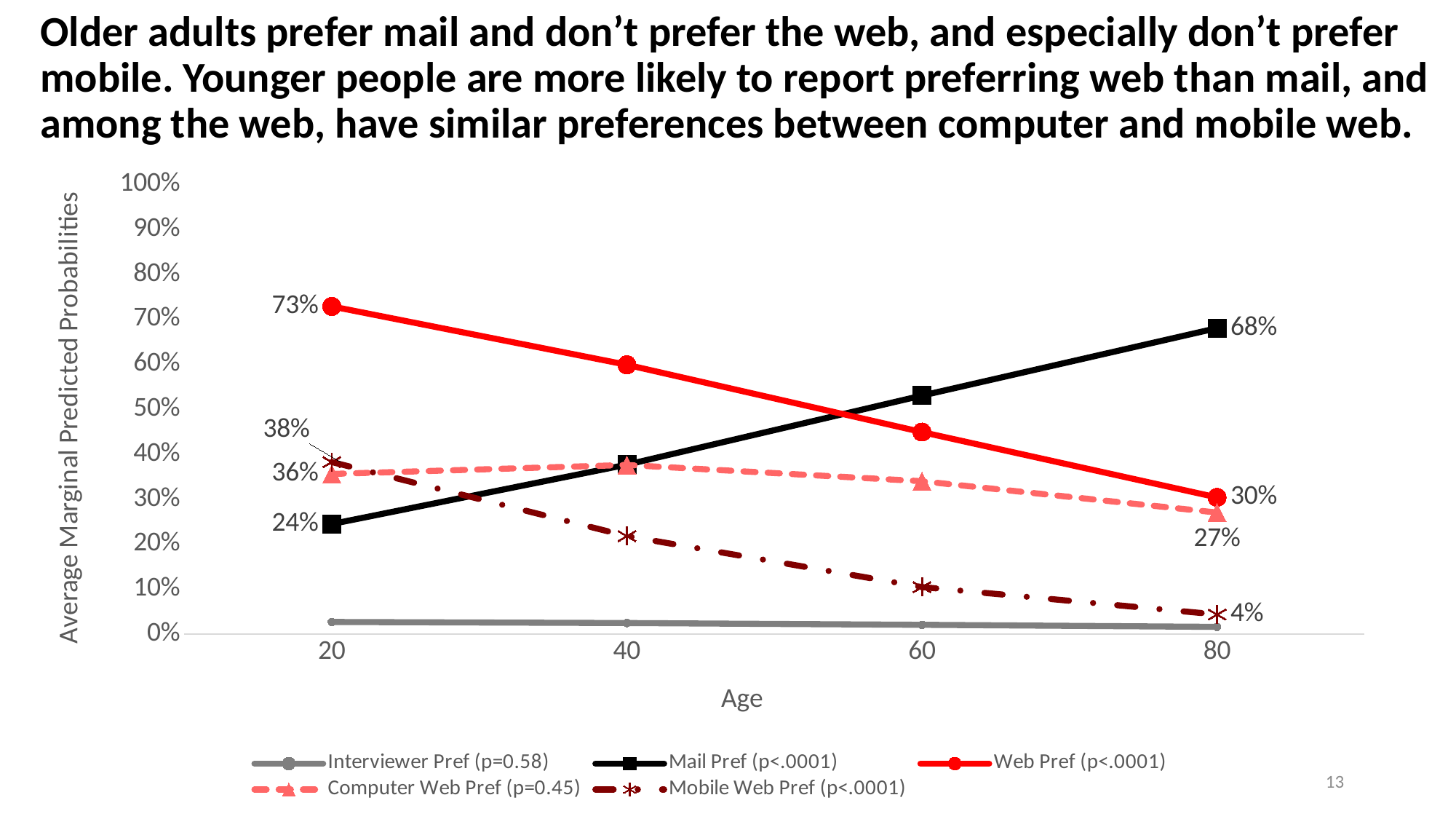
Does the Mail Pref series rise or fall as age increases? rise What type of chart is shown on the slide? line chart What is the Mail Pref value at age 80? 68% What is the difference between the Mail Pref value at age 80 and at age 20? 44% What is the difference between the Web Pref value at age 20 and at age 80? 43% Which is larger at age 20: Mail Pref or Web Pref? Web Pref Is the Web Pref value at age 40 greater or less than 50%? greater What is the Computer Web Pref value at age 20? 36% What is the Mobile Web Pref value at age 80? 4% How many age points are plotted on the x axis? 4 How many series does the legend list? 5 What is the Web Pref value at age 20? 73%